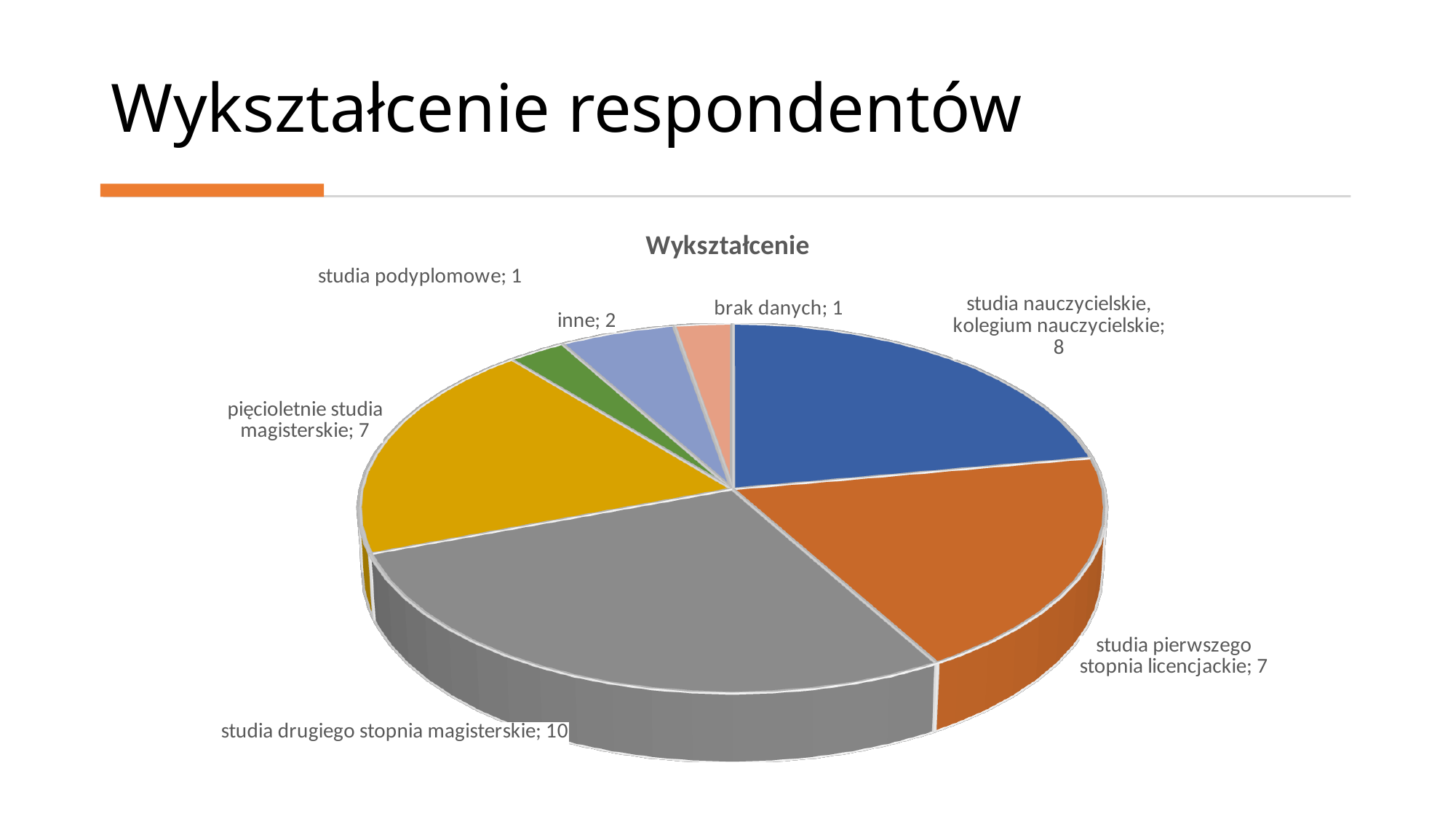
What is the value for 'brak danych'? 1 How many categories does the pie chart show? 7 Which category has the largest slice of the pie? studia drugiego stopnia magisterskie Which is larger: the value for 'studia nauczycielskie, kolegium nauczycielskie' or for 'studia pierwszego stopnia licencjackie'? studia nauczycielskie, kolegium nauczycielskie What type of chart is shown on the slide? pie chart What is the difference between the values for 'studia drugiego stopnia magisterskie' and 'studia nauczycielskie, kolegium nauczycielskie'? 2 What is the value for 'studia drugiego stopnia magisterskie'? 10 What is the title of the chart? Wykształcenie What is the total of all values shown in the pie chart? 36 What is the value for 'studia nauczycielskie, kolegium nauczycielskie'? 8 What is the value for 'inne'? 2 Which categories have the smallest value in the pie chart? studia podyplomowe and brak danych